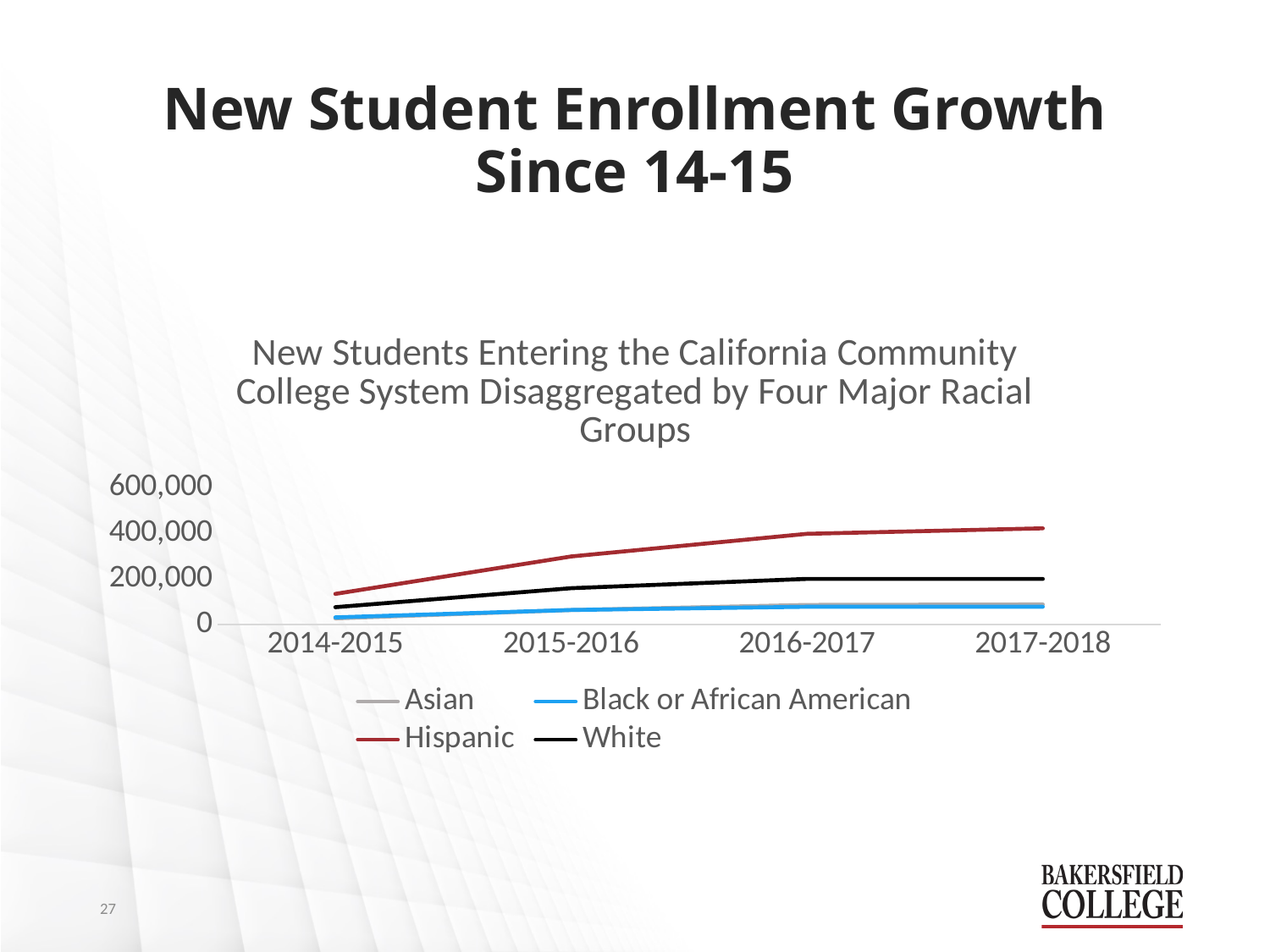
Is the value for Hispanic in 2016-2017 greater or less than 200,000? greater Is the value for Hispanic in 2014-2015 greater or less than 200,000? less Which racial group has the highest number of new students in 2017-2018? Hispanic What kind of chart is shown on the slide? Line chart Which series is drawn with the red line? Hispanic How many academic years are shown along the x axis? 4 Does the Hispanic line rise or fall from 2014-2015 to 2017-2018? Rise How many series does the legend list? 4 Which is larger in 2016-2017, the value for Hispanic or the value for White? Hispanic Which racial group has the highest number of new students in 2014-2015? Hispanic What is the title of the chart? New Students Entering the California Community College System Disaggregated by Four Major Racial Groups Is the value for White in 2014-2015 greater or less than 200,000? less